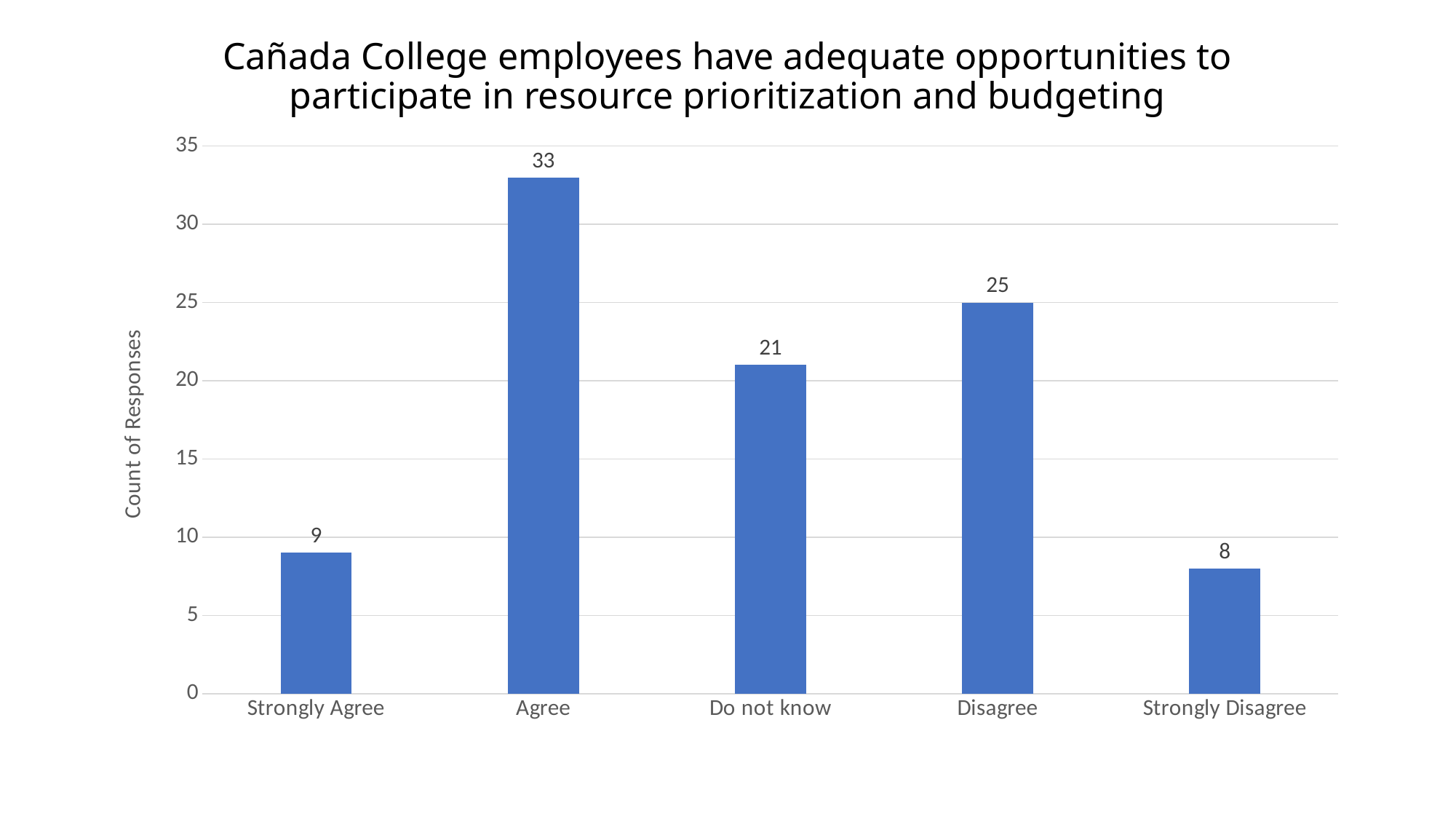
What kind of chart is shown on the slide? Bar chart Is the value for Disagree greater or less than 20? greater What is the count of responses for Do not know? 21 What is the difference between the counts for Strongly Agree and Strongly Disagree? 1 What is the count of responses for Strongly Disagree? 8 What is the count of responses for Agree? 33 Which has a larger count, Do not know or Disagree? Disagree What is the difference between the counts for Agree and Disagree? 8 Which response category has the highest count? Agree Which response category has the lowest count? Strongly Disagree What is the label of the vertical axis? Count of Responses How many response categories are shown on the x axis? 5